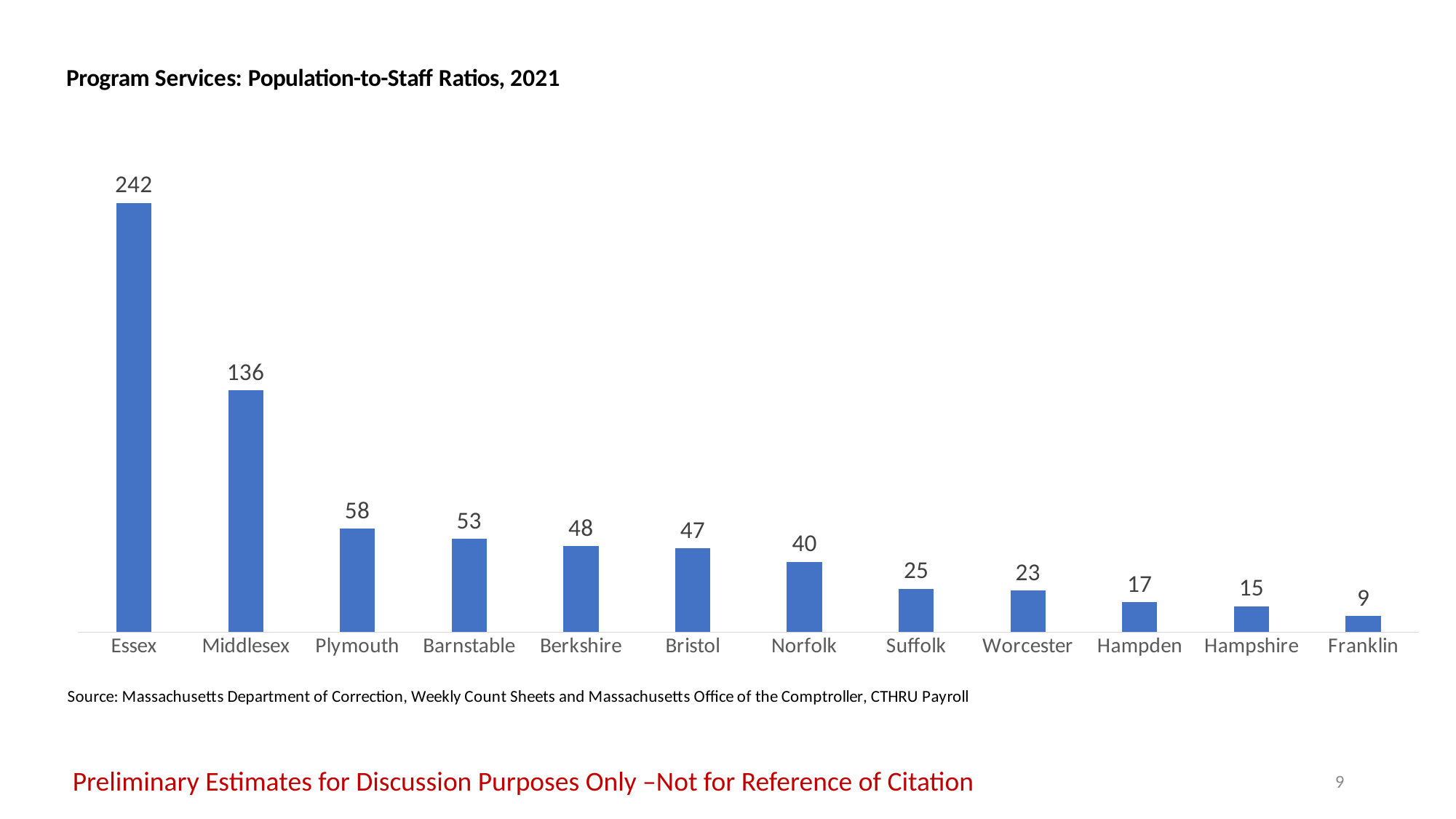
What is the difference between the ratios for Plymouth and Suffolk? 33 What is the population-to-staff ratio for Hampden? 17 What is the difference between the ratios for Essex and Middlesex? 106 What kind of chart is shown on the slide? Bar chart What is the population-to-staff ratio for Essex? 242 Do the values rise or fall from left to right across the chart? Fall What is the title of the chart? Program Services: Population-to-Staff Ratios, 2021 Which county has the highest population-to-staff ratio? Essex How many counties are shown in the chart? 12 What is the population-to-staff ratio for Norfolk? 40 Which has a higher population-to-staff ratio, Bristol or Worcester? Bristol Which county has the lowest population-to-staff ratio? Franklin